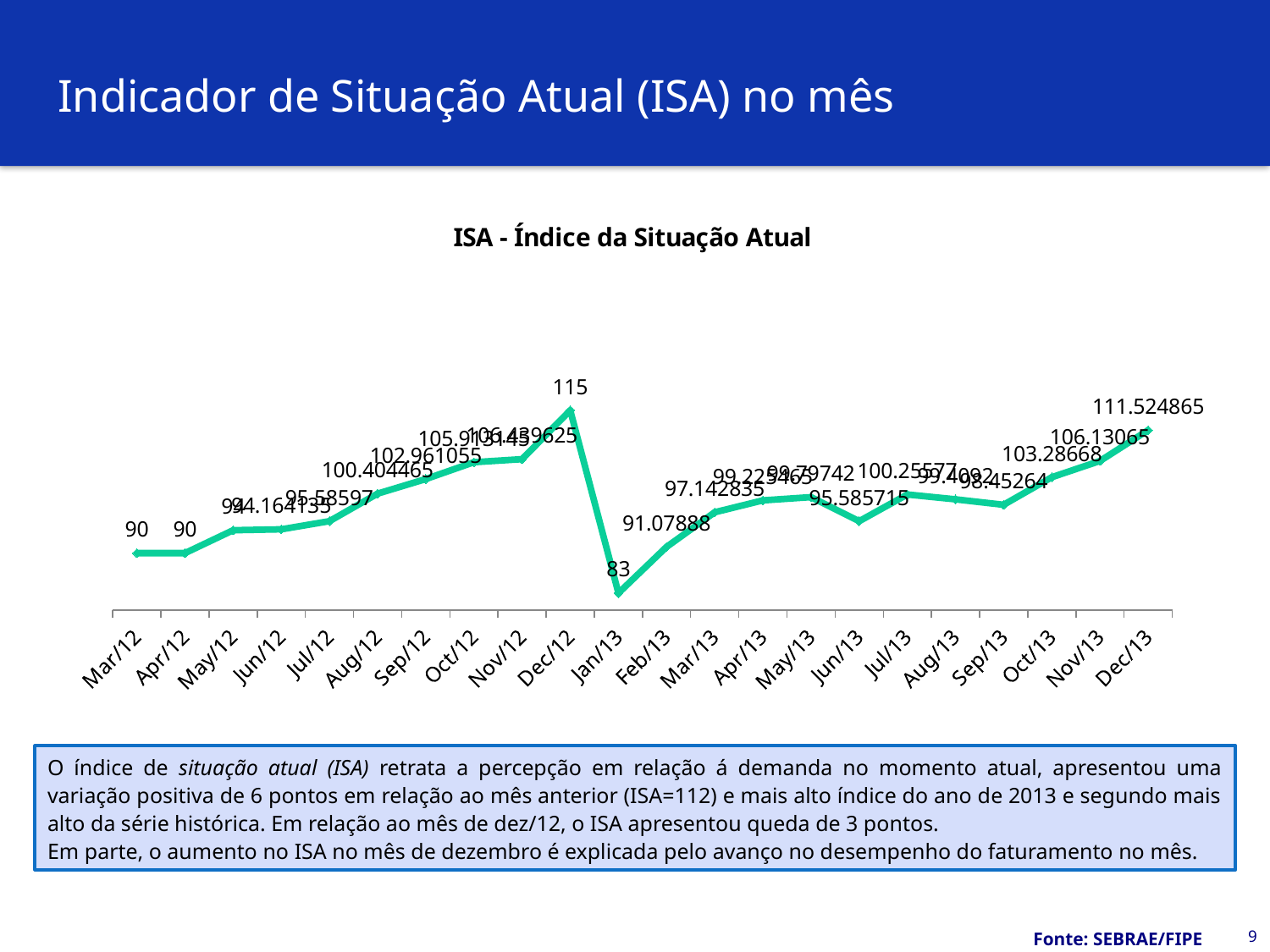
What is the difference between the ISA values for Dec/12 and Jan/13? 32 Which month has the lowest ISA value? Jan/13 What is the ISA value for Jan/13? 83 What is the ISA value for Feb/13? 91.07888 How many months are plotted on the chart? 22 Which month has the highest ISA value? Dec/12 What is the title of the chart? ISA - Índice da Situação Atual What is the ISA value for Dec/13? 111.524865 What is the ISA value for Mar/12? 90 Which is larger, the ISA value for Dec/12 or for Dec/13? Dec/12 What type of chart is shown on the slide? line chart What is the ISA value for Dec/12? 115